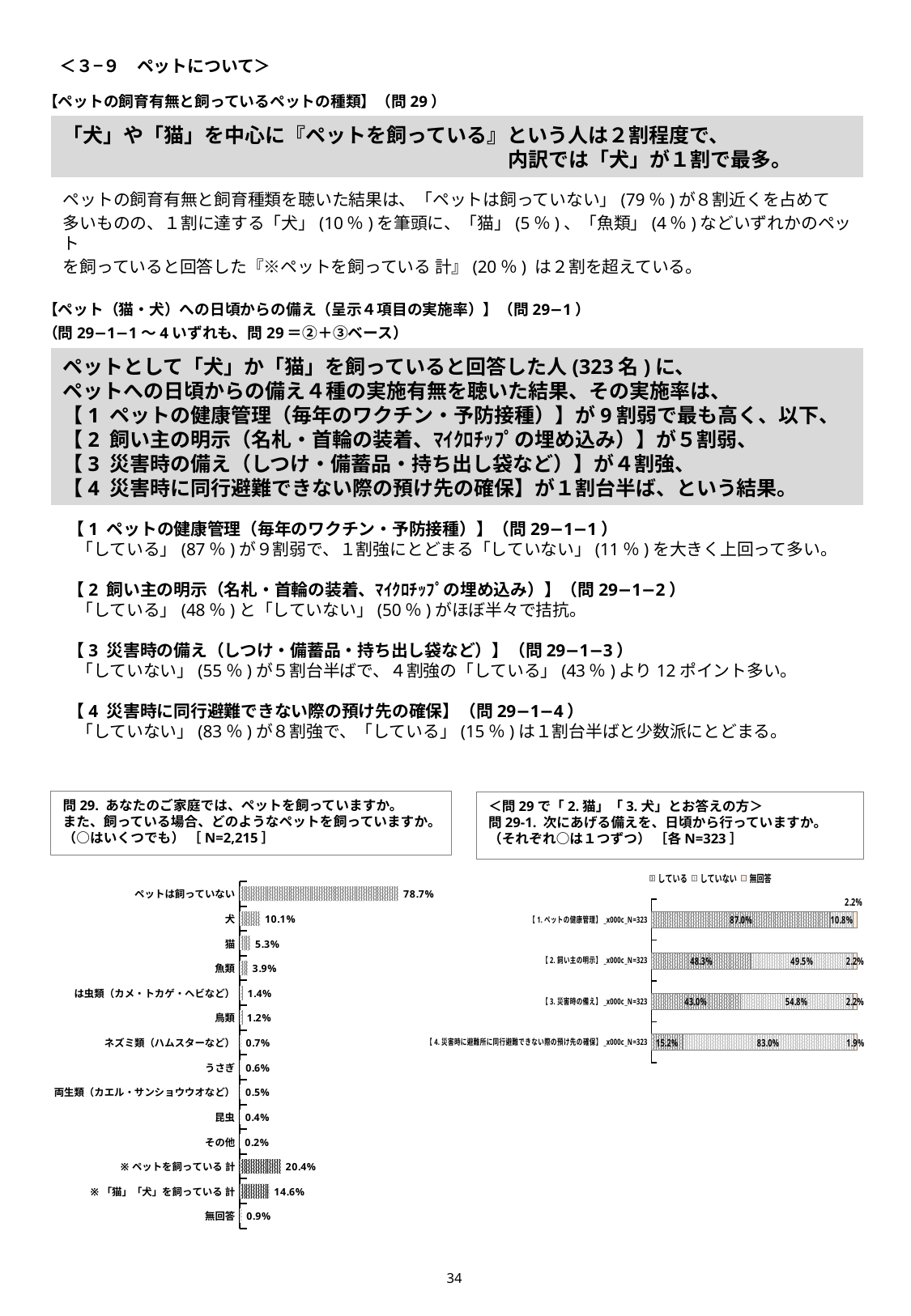
In the right chart (問29-1, preparedness), what is the total of the stacked bar for 3. 災害時の備え? 100.0% In the right chart (問29-1, preparedness), what is the していない value for 4. 災害時に避難所に同行避難できない際の預け先の確保? 83.0% In the left chart (問29, pet ownership), which category has the highest value? ペットは飼っていない In the left chart (問29, pet ownership), what is the value for 魚類? 3.9% In the right chart (問29-1, preparedness), how many series does the legend list? 3 In the left chart (問29, pet ownership), what is the difference between 犬 and 猫? 4.8% What type of chart is the left chart (問29, pet ownership)? Bar chart In the left chart (問29, pet ownership), how many categories are plotted? 14 In the right chart (問29-1, preparedness), what is the している value for 1. ペットの健康管理? 87.0% In the left chart (問29, pet ownership), which is larger, ※ペットを飼っている 計 or ※「猫」「犬」を飼っている 計? ※ペットを飼っている 計 In the left chart (問29, pet ownership), what is the value for 犬 (dog)? 10.1% In the right chart (問29-1, preparedness), which item has the lowest している value? 4. 災害時に避難所に同行避難できない際の預け先の確保